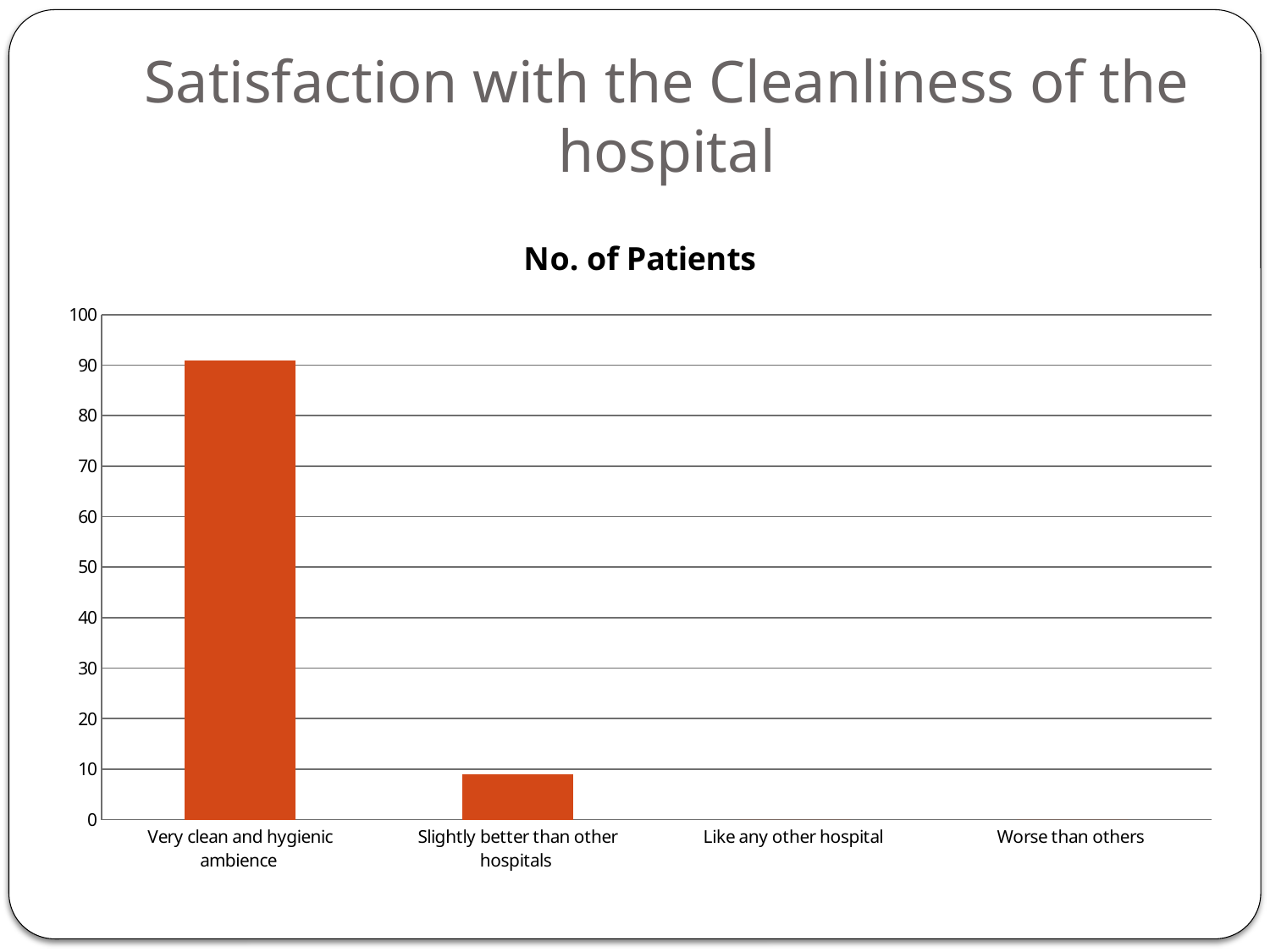
Is the value for 'Very clean and hygienic ambience' greater or less than 100? less Is the value for 'Like any other hospital' greater or less than 10? less What kind of chart is shown on the slide? bar chart Which is larger, the value for 'Very clean and hygienic ambience' or the value for 'Slightly better than other hospitals'? Very clean and hygienic ambience Which is larger, the value for 'Slightly better than other hospitals' or the value for 'Worse than others'? Slightly better than other hospitals What is the highest value shown on the y axis of the chart? 100 What is the title of the chart? No. of Patients Which category has the highest value in the chart? Very clean and hygienic ambience How many categories are shown on the x axis of the chart? 4 Do the values rise or fall moving from left to right along the x axis? fall